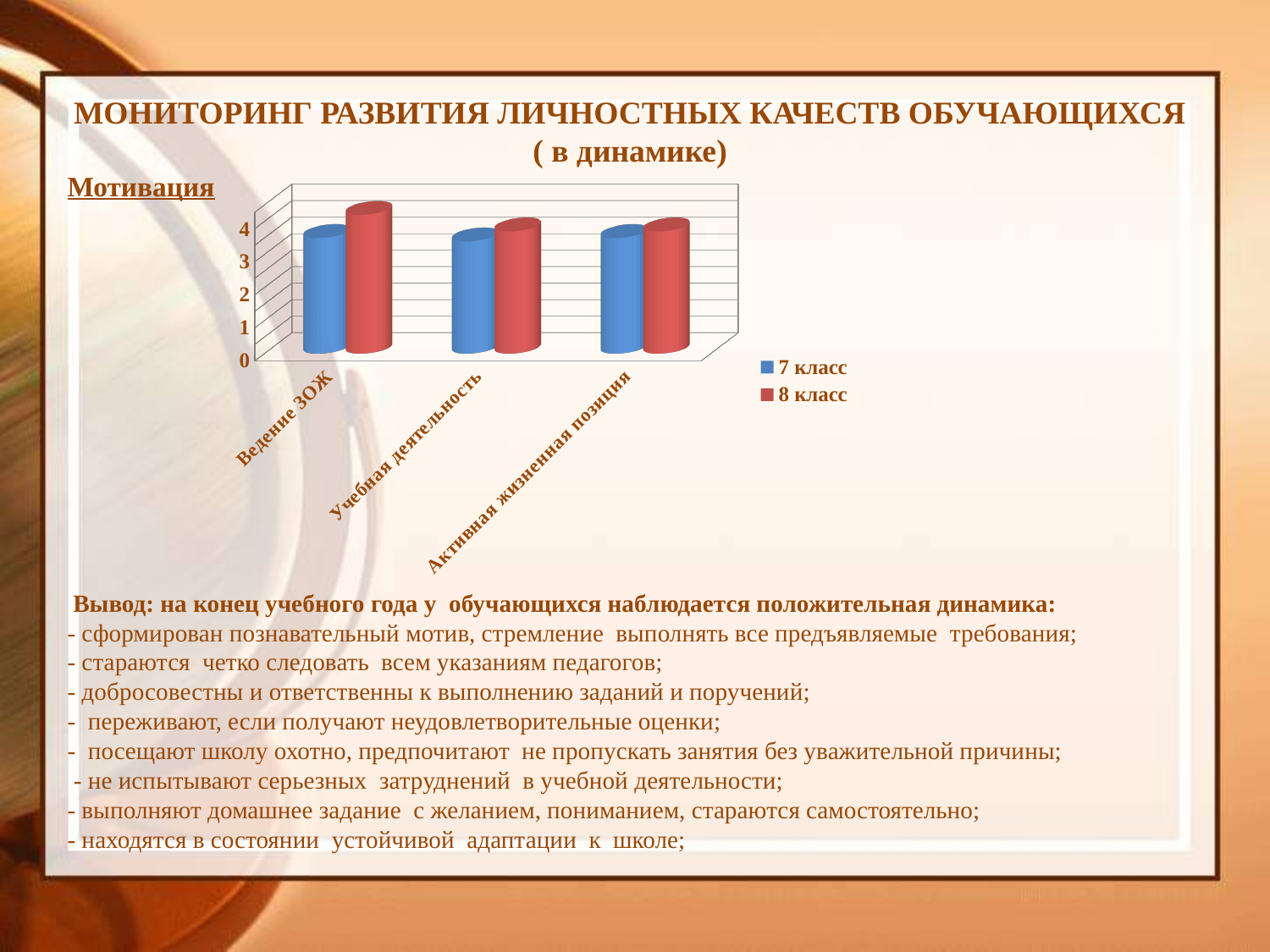
Is the value for 7 класс in the category Учебная деятельность greater or less than 1? greater Which colour represents the series 8 класс in the chart? red Is the value for 7 класс in the category Ведение ЗОЖ greater or less than 2? greater Which category has the highest value for the series 8 класс? Ведение ЗОЖ How many series does the chart legend list? 2 What kind of chart is shown on the slide? bar chart How many categories are shown on the x axis of the chart? 3 What is the highest tick value shown on the vertical axis of the chart? 4 Is the value for 8 класс in the category Активная жизненная позиция greater or less than 2? greater What are the two series named in the chart legend? 7 класс and 8 класс For the category Учебная деятельность, which series has the larger value, 7 класс or 8 класс? 8 класс For the category Ведение ЗОЖ, which series has the larger value, 7 класс or 8 класс? 8 класс